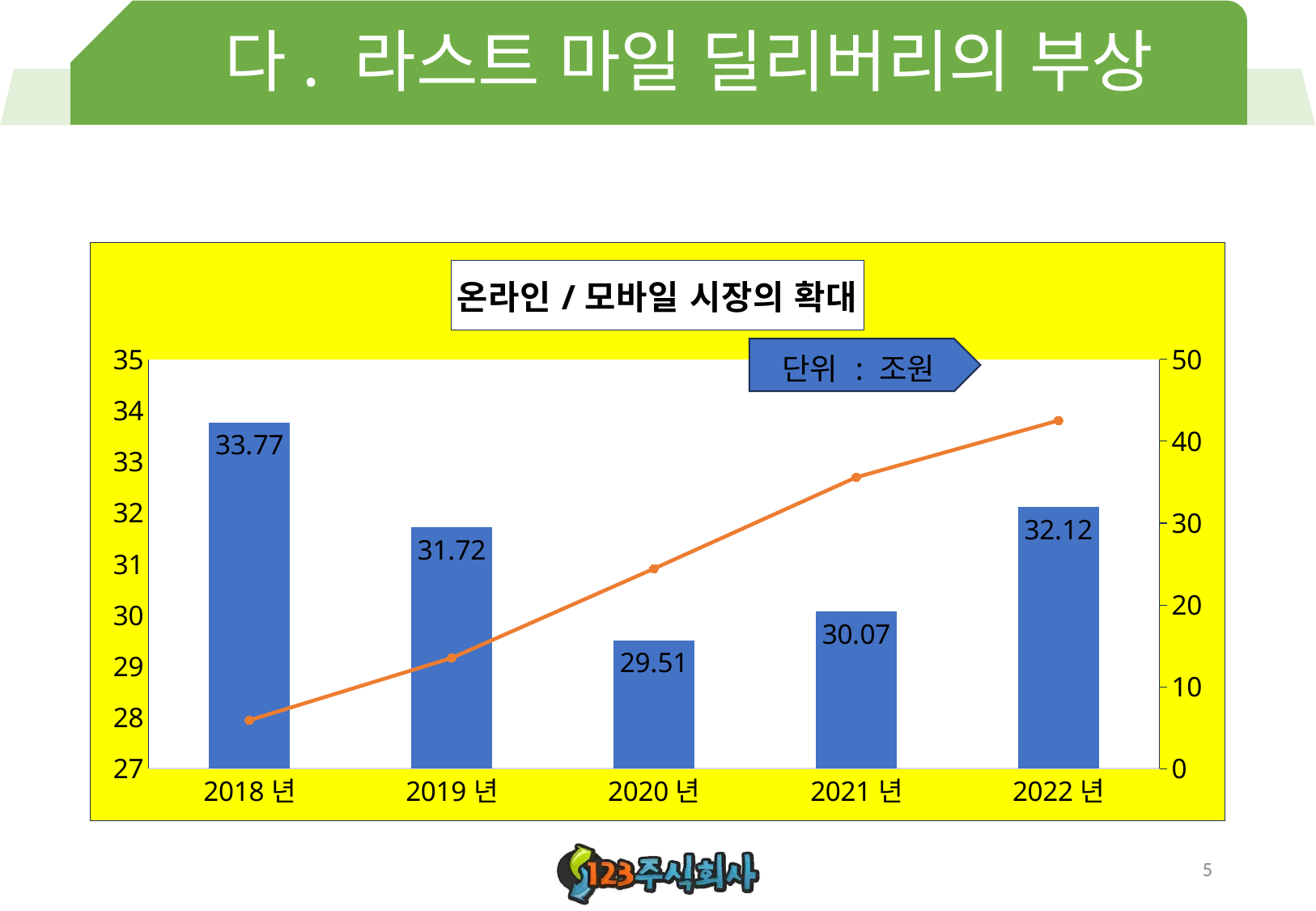
Which year has the lowest bar value? 2020 년 How many years are shown on the x axis? 5 What is the value of the bar for 2018 년? 33.77 Which bar value is larger, 2021 년 or 2022 년? 2022 년 What is the value of the bar for 2020 년? 29.51 Does the orange line rise or fall from 2018 년 to 2022 년? rise Is the line value for 2022 년 on the right axis greater or less than 40? greater What is the title of the chart? 온라인 / 모바일 시장의 확대 Is the line value for 2018 년 on the right axis greater or less than 10? less What is the difference between the bar values for 2018 년 and 2019 년? 2.05 What is the value of the bar for 2022 년? 32.12 Which year has the highest bar value? 2018 년